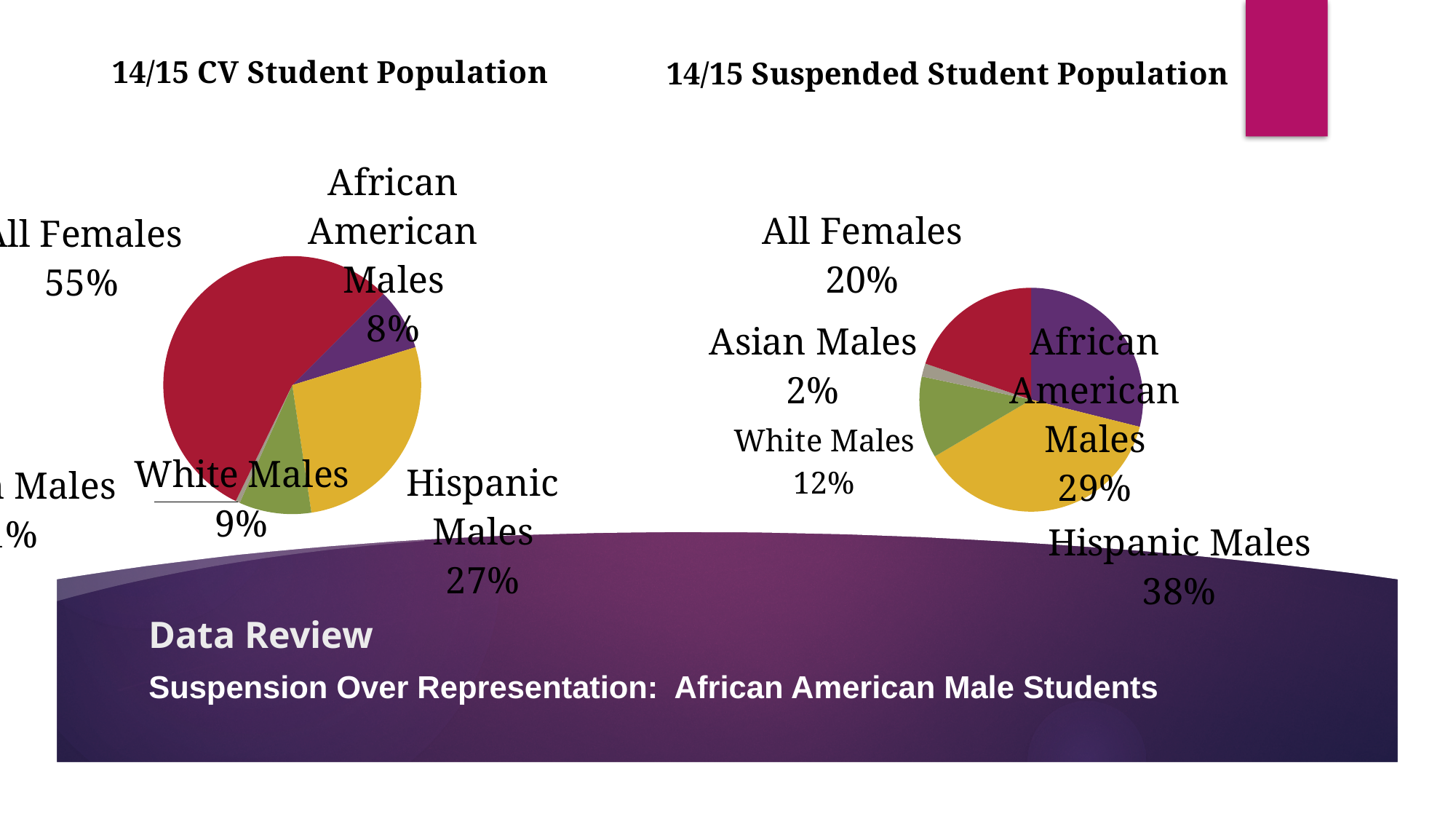
In the 14/15 CV Student Population chart, what percentage is African American Males? 8% In the 14/15 CV Student Population chart, which group has the largest share? All Females In the 14/15 Suspended Student Population chart, what percentage is African American Males? 29% In the 14/15 Suspended Student Population chart, which group has the smallest share? Asian Males How many groups are shown in the 14/15 Suspended Student Population chart? 5 In the 14/15 Suspended Student Population chart, what percentage is Hispanic Males? 38% What kind of chart is the 14/15 Suspended Student Population chart? Pie chart In the 14/15 Suspended Student Population chart, which group has the largest share? Hispanic Males In the 14/15 Suspended Student Population chart, what percentage is Asian Males? 2% In the 14/15 CV Student Population chart, what percentage is Hispanic Males? 27% How many percentage points higher is the African American Males share in the 14/15 Suspended Student Population chart than in the 14/15 CV Student Population chart? 21 percentage points In the 14/15 CV Student Population chart, what percentage is All Females? 55%